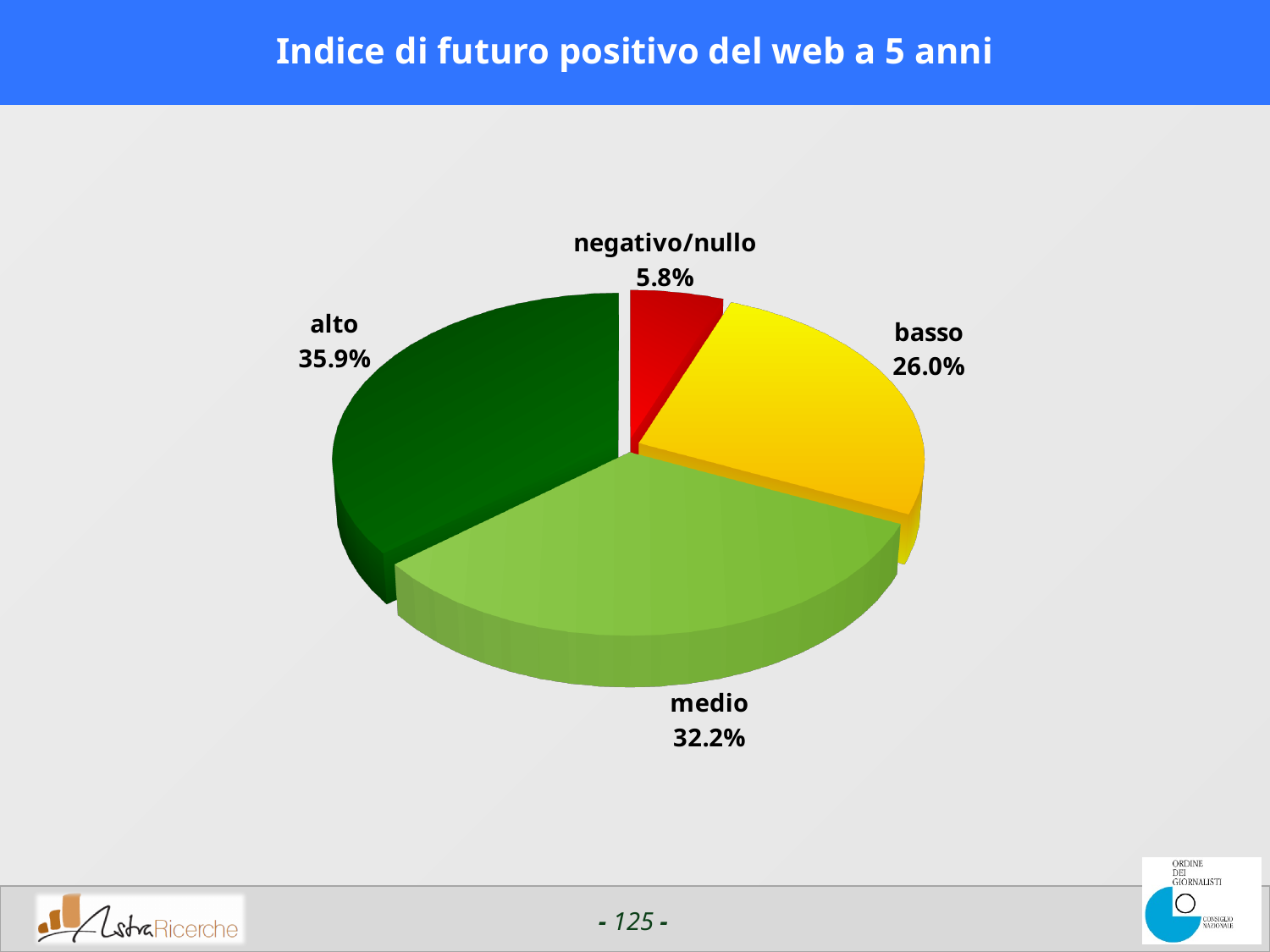
What is the difference in percentage points between "basso" and "negativo/nullo"? 20.2 Which is larger, the share for "basso" or the share for "medio"? medio What is the share for "medio"? 32.2% Which category has the largest share? alto What is the share for "alto"? 35.9% Which category has the smallest share? negativo/nullo What is the difference in percentage points between "alto" and "medio"? 3.7 What is the share for "negativo/nullo"? 5.8% What type of chart is shown on the slide? pie chart What is the share for "basso"? 26.0% How many slices does the pie chart have? 4 What is the title of the chart? Indice di futuro positivo del web a 5 anni